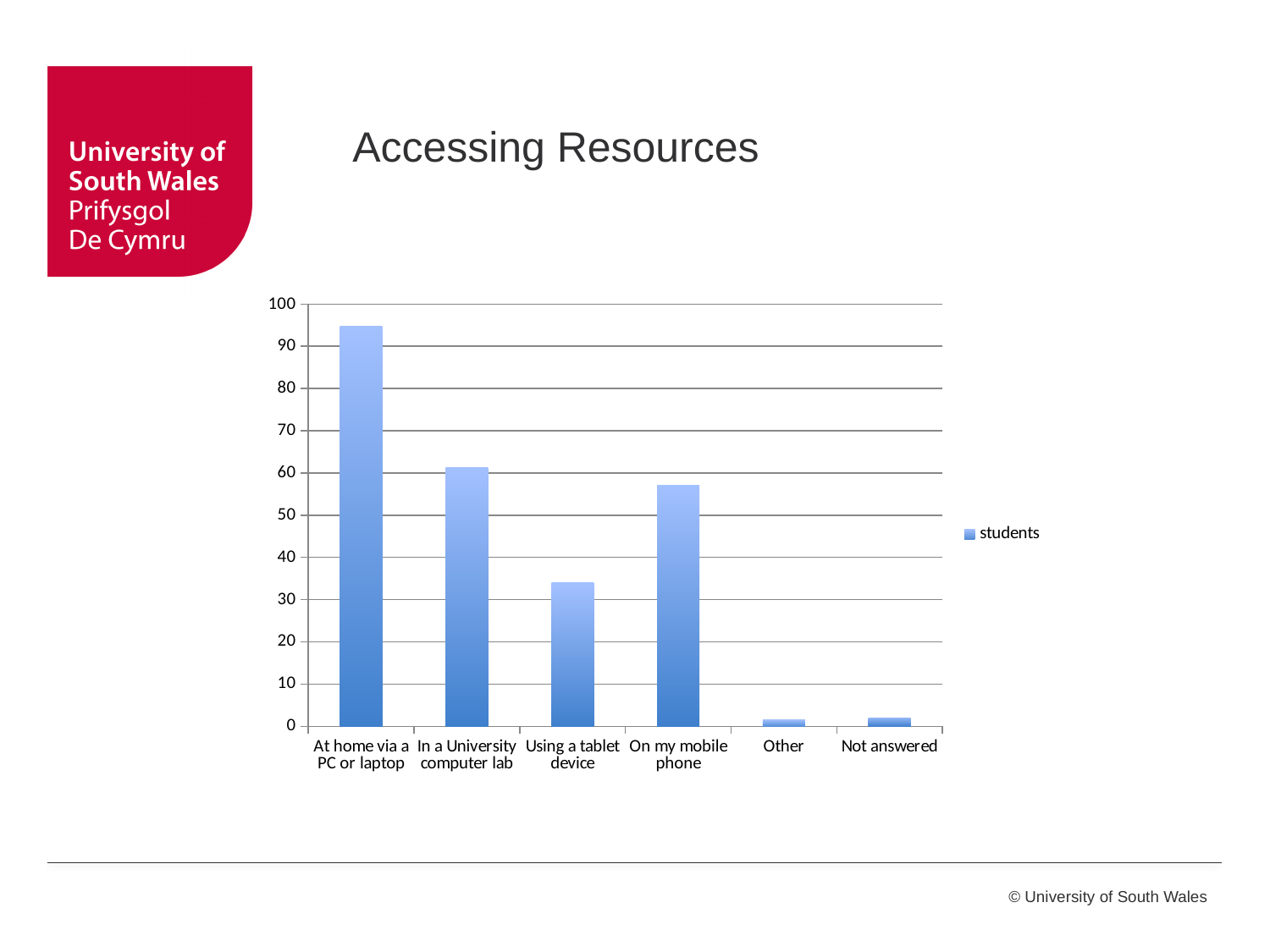
Is the value for 'Other' greater or less than 10? less Is the value for 'On my mobile phone' greater or less than 60? less Which is larger, the value for 'Using a tablet device' or the value for 'On my mobile phone'? On my mobile phone Is the value for 'At home via a PC or laptop' greater or less than 90? greater How many series does the chart legend list? 1 Which category has the highest value in the chart? At home via a PC or laptop What type of chart is shown on the slide? bar chart What is the name of the series shown in the chart legend? students How many categories are shown on the x axis of the chart? 6 What is the title of the slide containing the chart? Accessing Resources